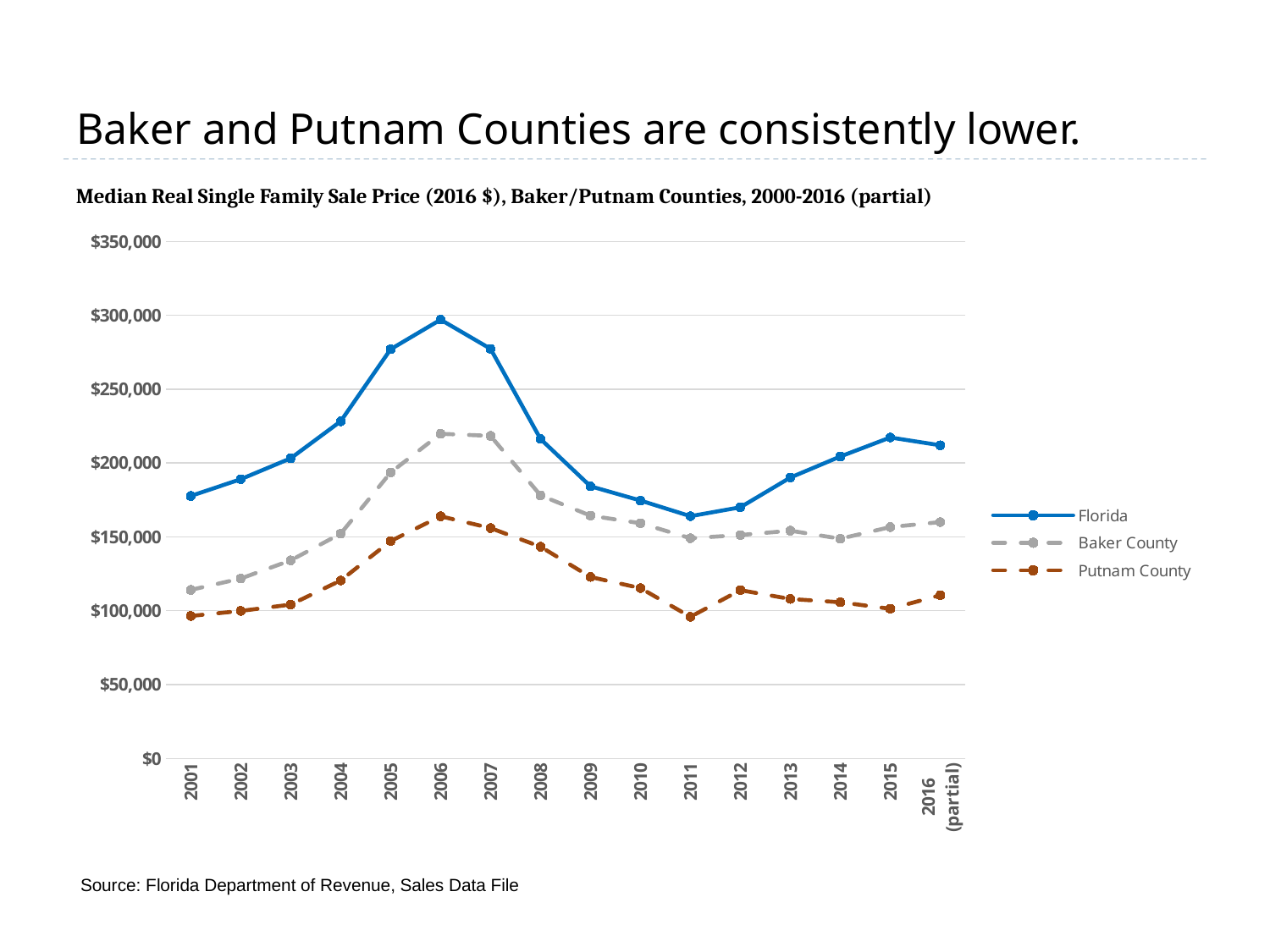
Does the Florida series rise or fall from 2006 to 2011? Fall Which series has the higher value in 2006, Baker County or Putnam County? Baker County How many years are shown along the x axis? 16 What kind of chart is shown on the slide? Line chart What is the title of the chart? Median Real Single Family Sale Price (2016 $), Baker/Putnam Counties, 2000-2016 (partial) In which year does the Florida series reach its lowest value? 2011 In which year does the Florida series reach its highest value? 2006 Is the value for Florida in 2006 greater or less than $250,000? greater In which year does the Putnam County series reach its highest value? 2006 Is the value for Baker County in 2006 greater or less than $200,000? greater How many series does the legend list? 3 Is the value for Putnam County in 2006 greater or less than $150,000? greater